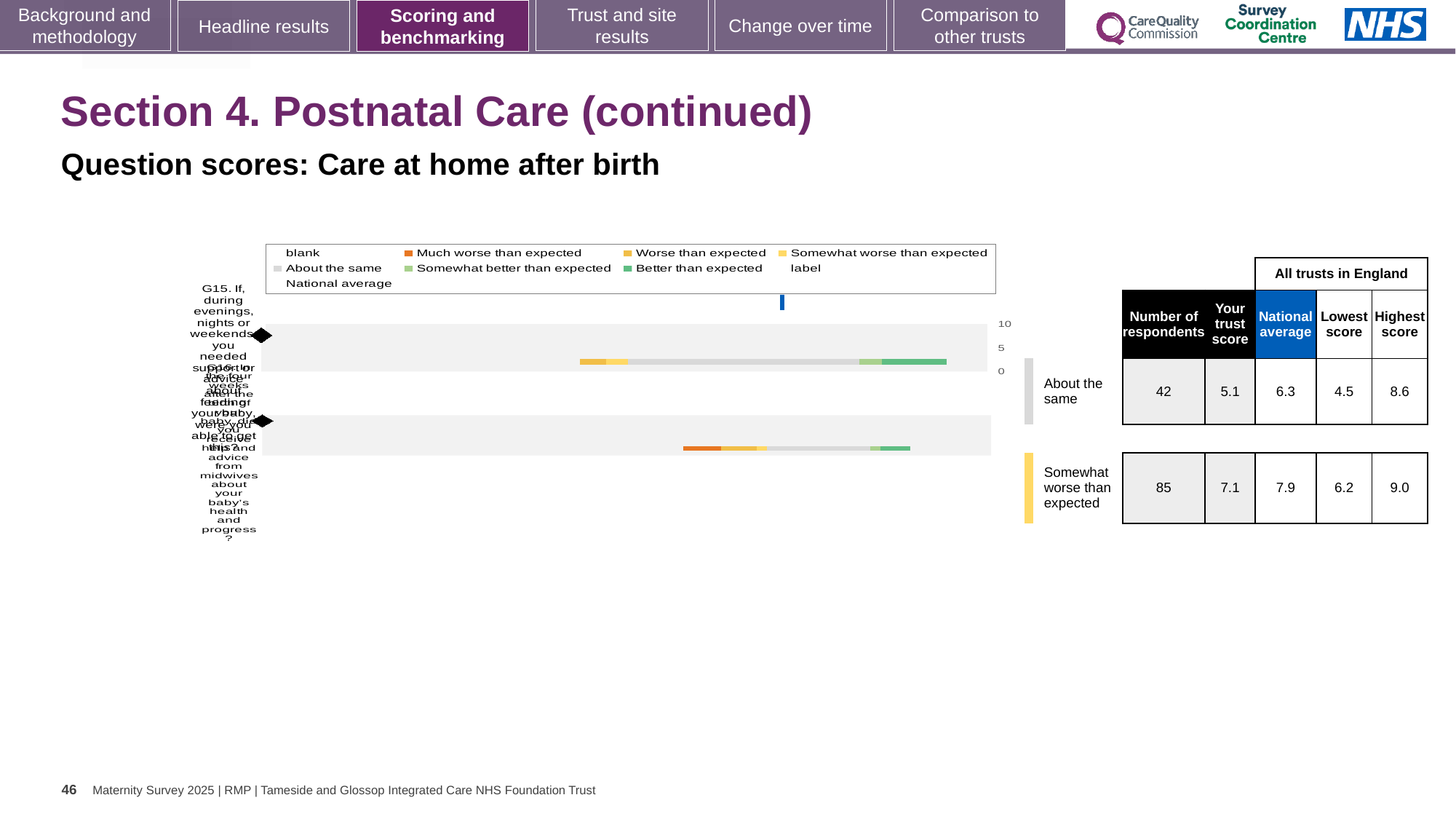
What heading appears above the National average, Lowest score and Highest score columns? All trusts in England For the question rated 'Somewhat worse than expected', what is the difference between the highest score and the lowest score? 2.8 Which question row has more respondents, 'About the same' or 'Somewhat worse than expected'? Somewhat worse than expected What is the national average for the question rated 'About the same'? 6.3 What is the trust score for the question rated 'Somewhat worse than expected'? 7.1 What is the highest score for the question rated 'Somewhat worse than expected'? 9.0 For the question rated 'About the same', how much higher is the national average than the trust score? 1.2 How many question rows (bars) does the chart show? 2 What is the number of respondents for the question rated 'About the same'? 42 What kind of chart is shown on the slide? bar chart What colour does the legend use for 'Much worse than expected'? orange What is the lowest score for the question rated 'About the same'? 4.5